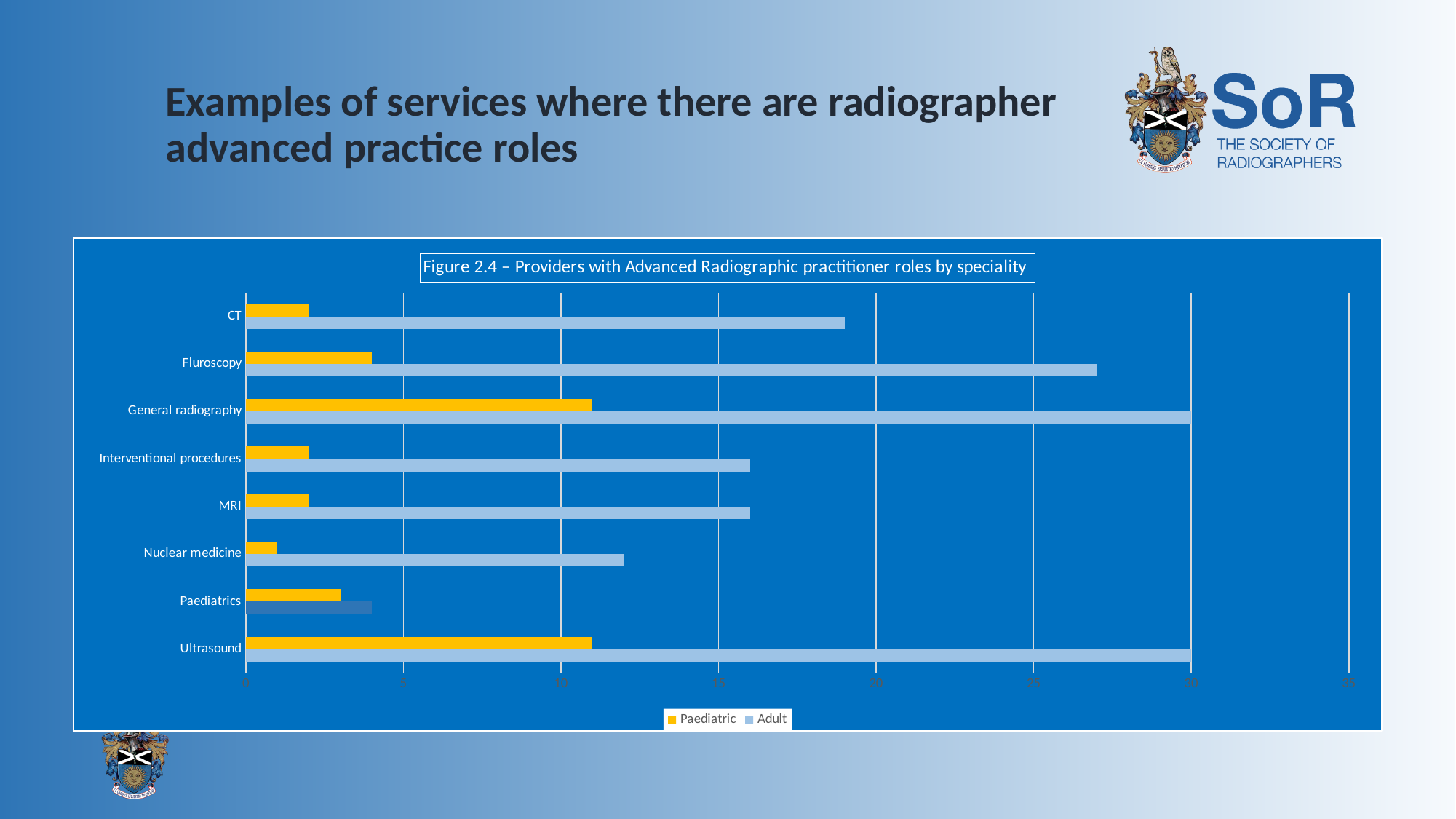
Is the Adult value for CT greater or less than 20? less Which is larger, the Paediatric value for Fluroscopy or the Paediatric value for CT? Fluroscopy Which speciality has the lowest Adult value? Paediatrics How many specialities (categories) are plotted in the chart? 8 Is the Adult value for Fluroscopy greater or less than 25? greater Which speciality has the lowest Paediatric value? Nuclear medicine What kind of chart is shown on the slide? Bar chart What is the title of the chart? Figure 2.4 – Providers with Advanced Radiographic practitioner roles by speciality Which series is shown in yellow in the chart? Paediatric Which is larger, the Adult value for Fluroscopy or the Adult value for CT? Fluroscopy How many series does the chart legend list? 2 Is the Adult value for Nuclear medicine greater or less than 10? greater